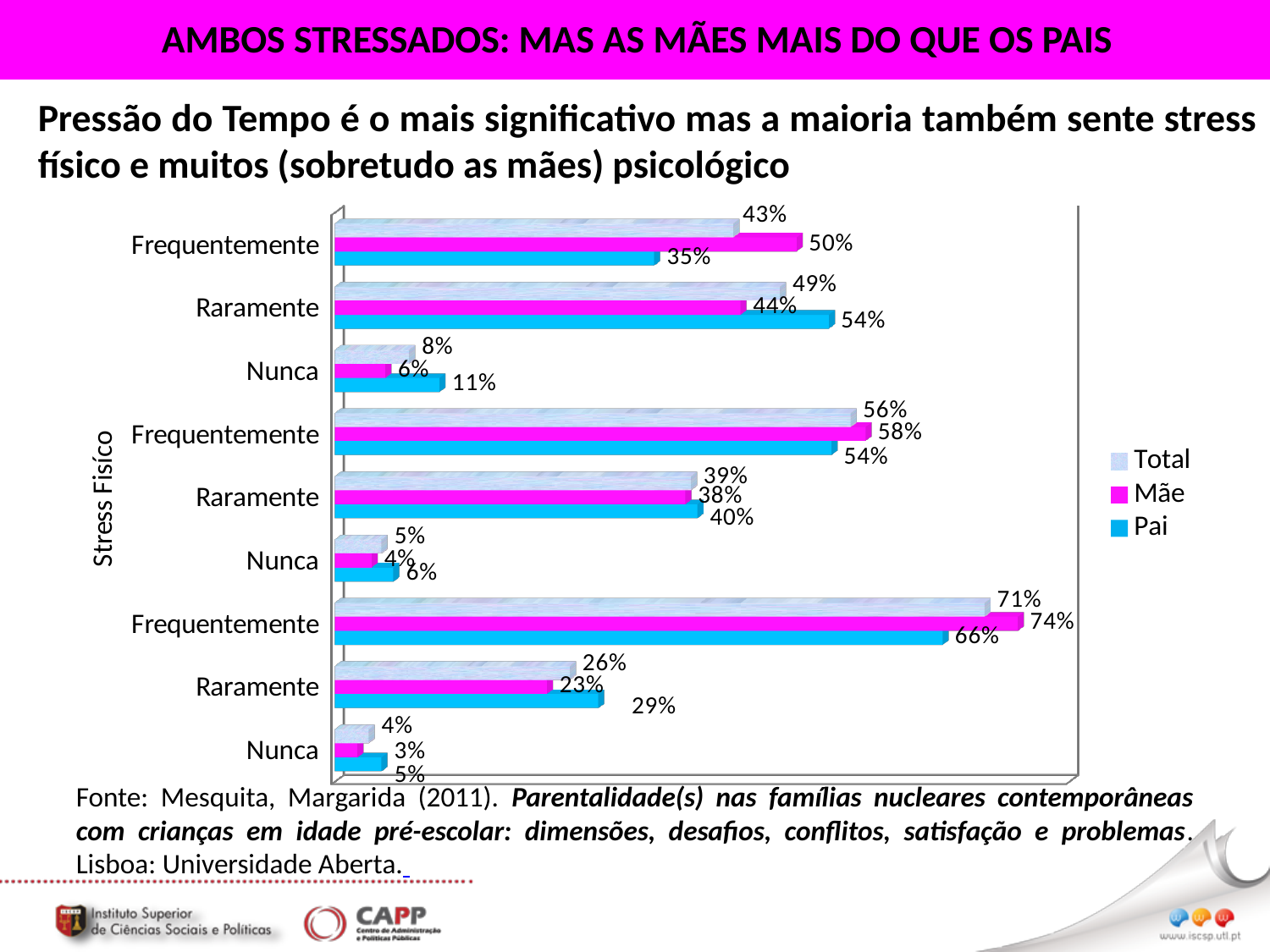
In the Stress Fisíco group, what is the Mãe value for Frequentemente? 58% How many category rows (Frequentemente/Raramente/Nunca entries) are plotted on the vertical axis? 9 In the topmost Frequentemente row of the chart, what is the Pai value? 35% In the Stress Fisíco group, which is larger for Frequentemente: the Mãe value or the Pai value? Mãe In the Stress Fisíco group, what is the Total value for Nunca? 5% In the Stress Fisíco group, what is the Pai value for Raramente? 40% What is the highest value shown anywhere in the chart? 74% How many series does the chart legend list? 3 In the Stress Fisíco group, what is the Total value for Raramente? 39% What kind of chart is shown on the slide? Bar chart In the Stress Fisíco group, what is the difference between the Mãe and Pai values for Frequentemente? 4 percentage points What are the three series named in the chart legend? Total, Mãe, Pai